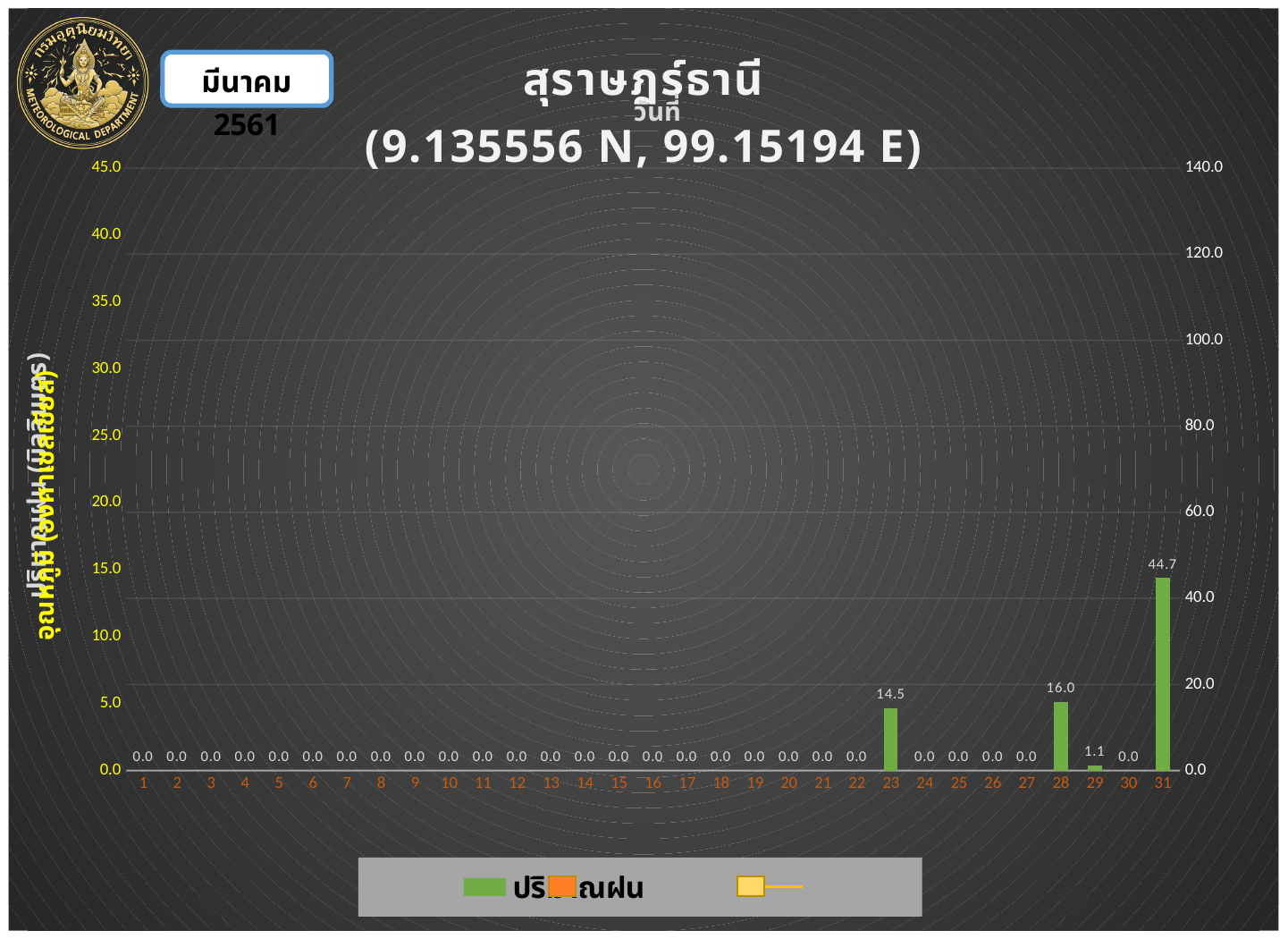
What is the difference between the rainfall values for day 28 and day 23? 1.5 What is the station name given in the chart title? สุราษฎร์ธานี Which day has the highest rainfall value? 31 What is the difference between the rainfall values for day 31 and day 28? 28.7 What is the rainfall value for day 29? 1.1 What is the rainfall value for day 28? 16.0 What is the rainfall value for day 23? 14.5 What kind of chart is shown on the slide? bar chart Is the rainfall value for day 31 greater or less than 40.0 on the right axis? greater Which is larger, the rainfall value for day 23 or for day 28? day 28 How many days are shown on the x axis? 31 What is the rainfall value for day 31? 44.7